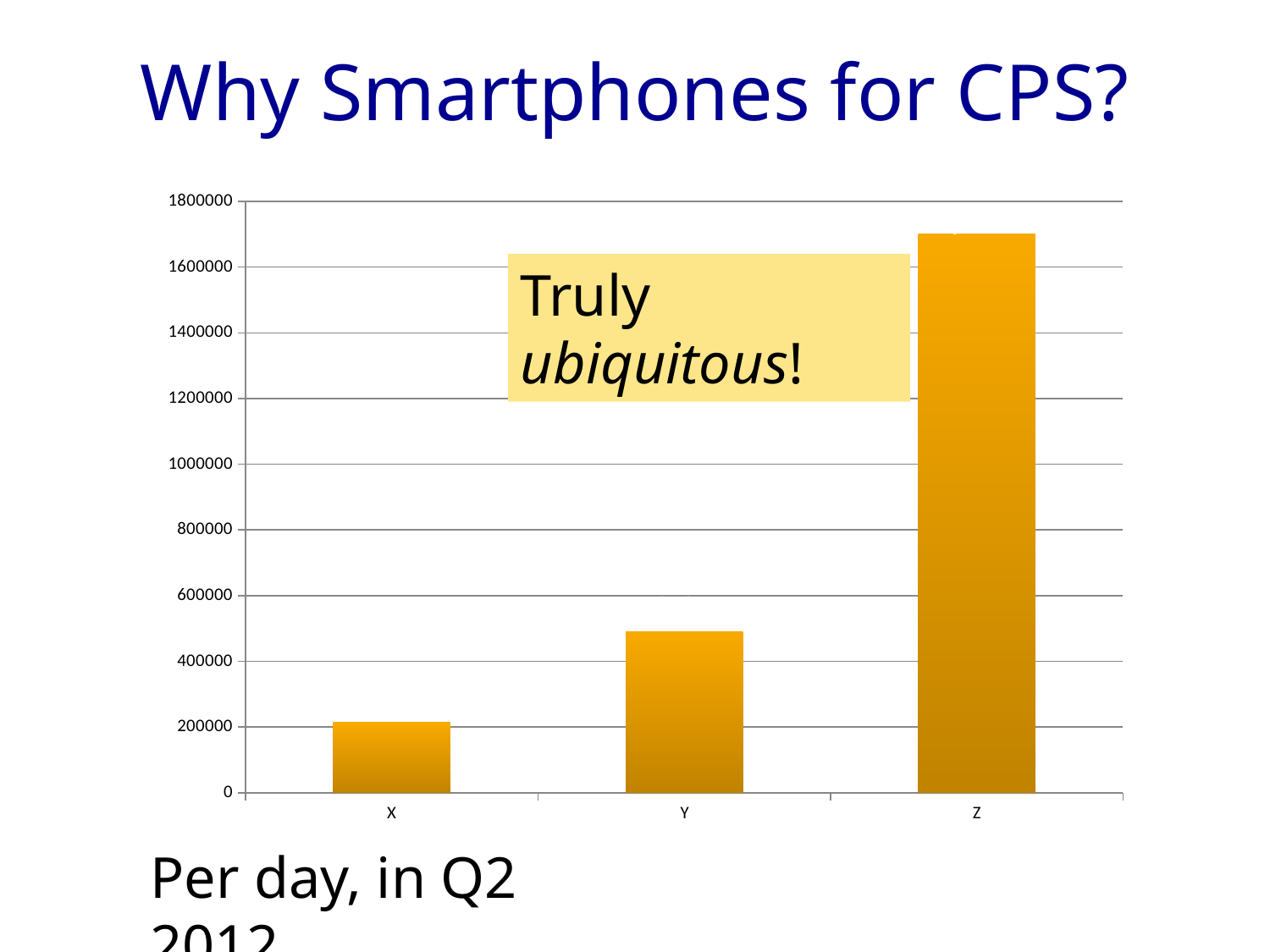
Is the value for Y greater or less than 400000? greater What text is shown in the highlighted box overlaid on the chart? Truly ubiquitous! Do the bar values rise or fall going from X to Z along the x axis? rise Which category has the lowest bar in the chart? X Is the value for X greater or less than 400000? less Which is larger, the value for Y or the value for X? Y Is the value for Z greater or less than 1600000? greater Which is larger, the value for Z or the value for Y? Z How many categories are plotted on the x axis of the chart? 3 What kind of chart is shown on the slide? bar chart Which category has the highest bar in the chart? Z